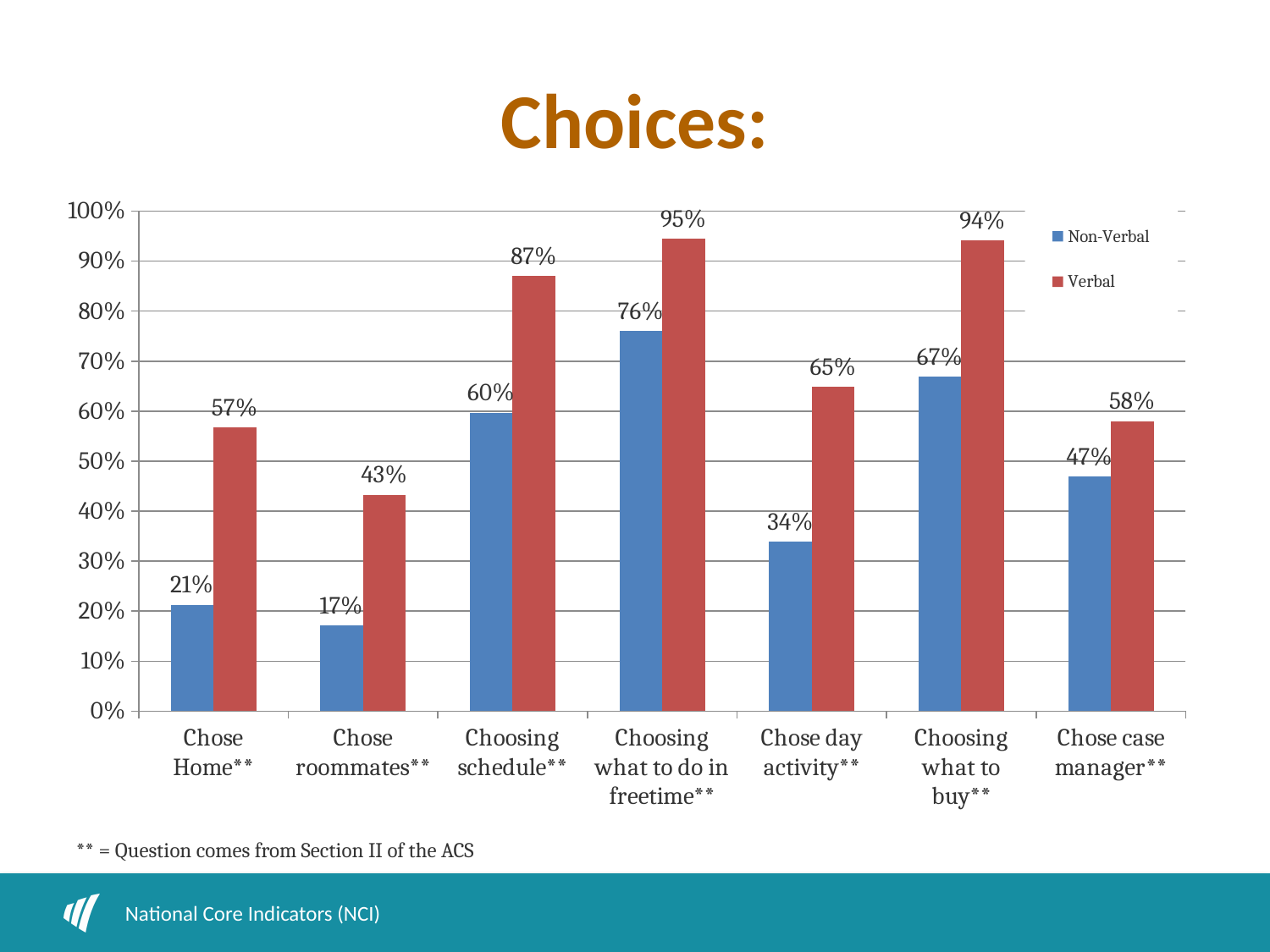
Which category has the highest Verbal value? Choosing what to do in freetime** What is the difference between the Verbal and Non-Verbal values for Chose Home**? 36% What is the title of the chart? Choices: What is the difference between the Verbal and Non-Verbal values for Chose day activity**? 31% What is the Non-Verbal value for Chose Home**? 21% How many categories are shown on the x axis? 7 Which is larger, the Non-Verbal value for Choosing what to buy** or the Verbal value for Chose day activity**? Non-Verbal value for Choosing what to buy** What is the Verbal value for Choosing schedule**? 87% What kind of chart is shown on the slide? Bar chart How many series does the legend list? 2 Which category has the lowest Non-Verbal value? Chose roommates** What is the Verbal value for Chose case manager**? 58%